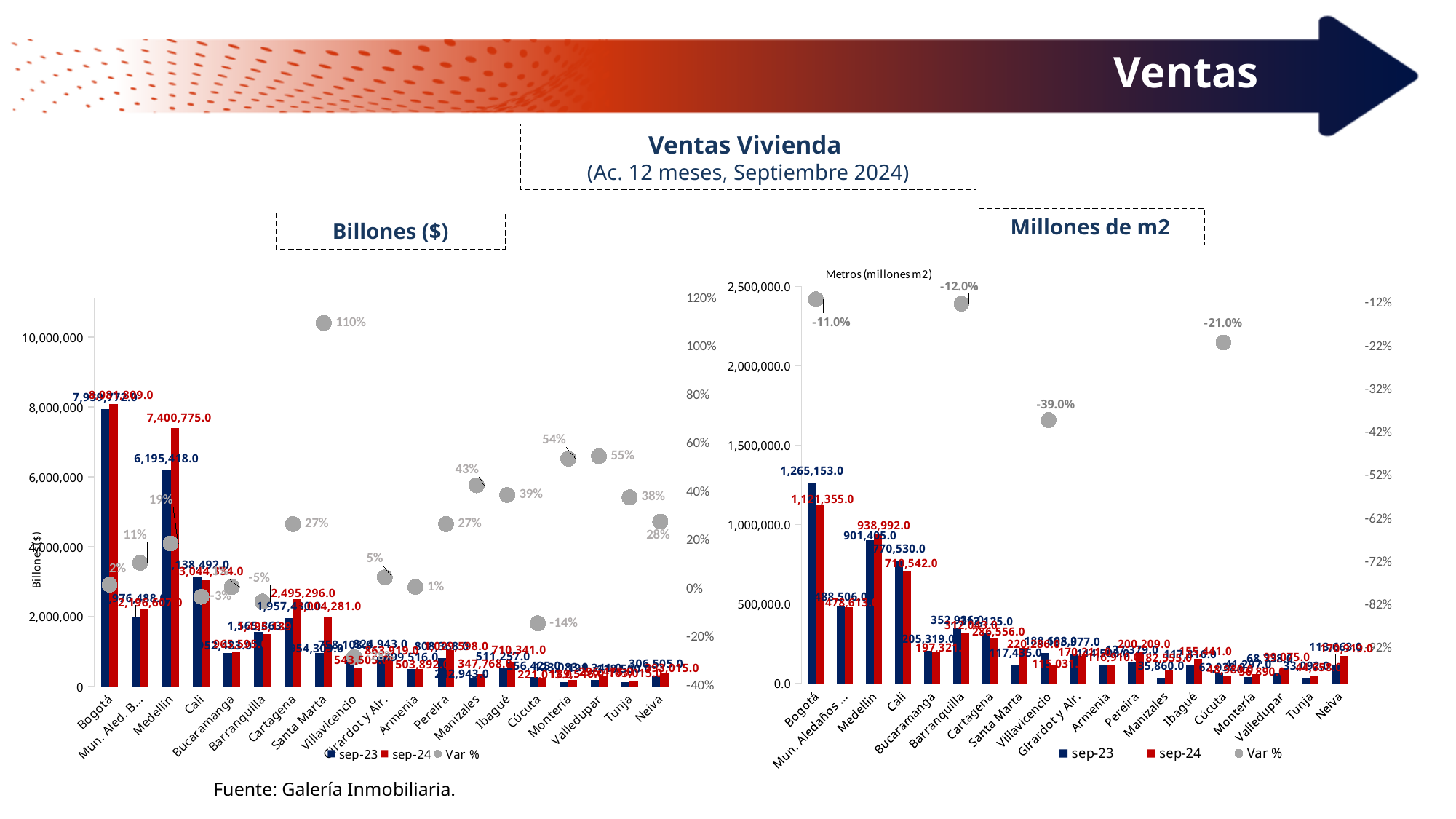
In the Millones de m2 chart, what is the Var % for Villavicencio? -39.0% In the Millones de m2 chart, what is the sep-23 value for Bogotá? 1,265,153.0 How many cities are shown on the x axis of the Billones ($) chart? 19 In the Millones de m2 chart, which is larger for Cali: the sep-23 value or the sep-24 value? sep-23 In the Billones ($) chart, which city has the highest Var %? Santa Marta How many series does the legend of the Millones de m2 chart list? 3 In the Billones ($) chart, what is the difference between the sep-24 and sep-23 values for Medellín? 1,205,357.0 In the Billones ($) chart, what is the Var % for Cúcuta? -14% In the Billones ($) chart, what is the Var % for Santa Marta? 110% In the Billones ($) chart, what is the sep-24 value for Medellín? 7,400,775.0 In the Billones ($) chart, what is the sep-23 value for Medellín? 6,195,418.0 In the Millones de m2 chart, what is the sep-24 value for Bogotá? 1,121,355.0